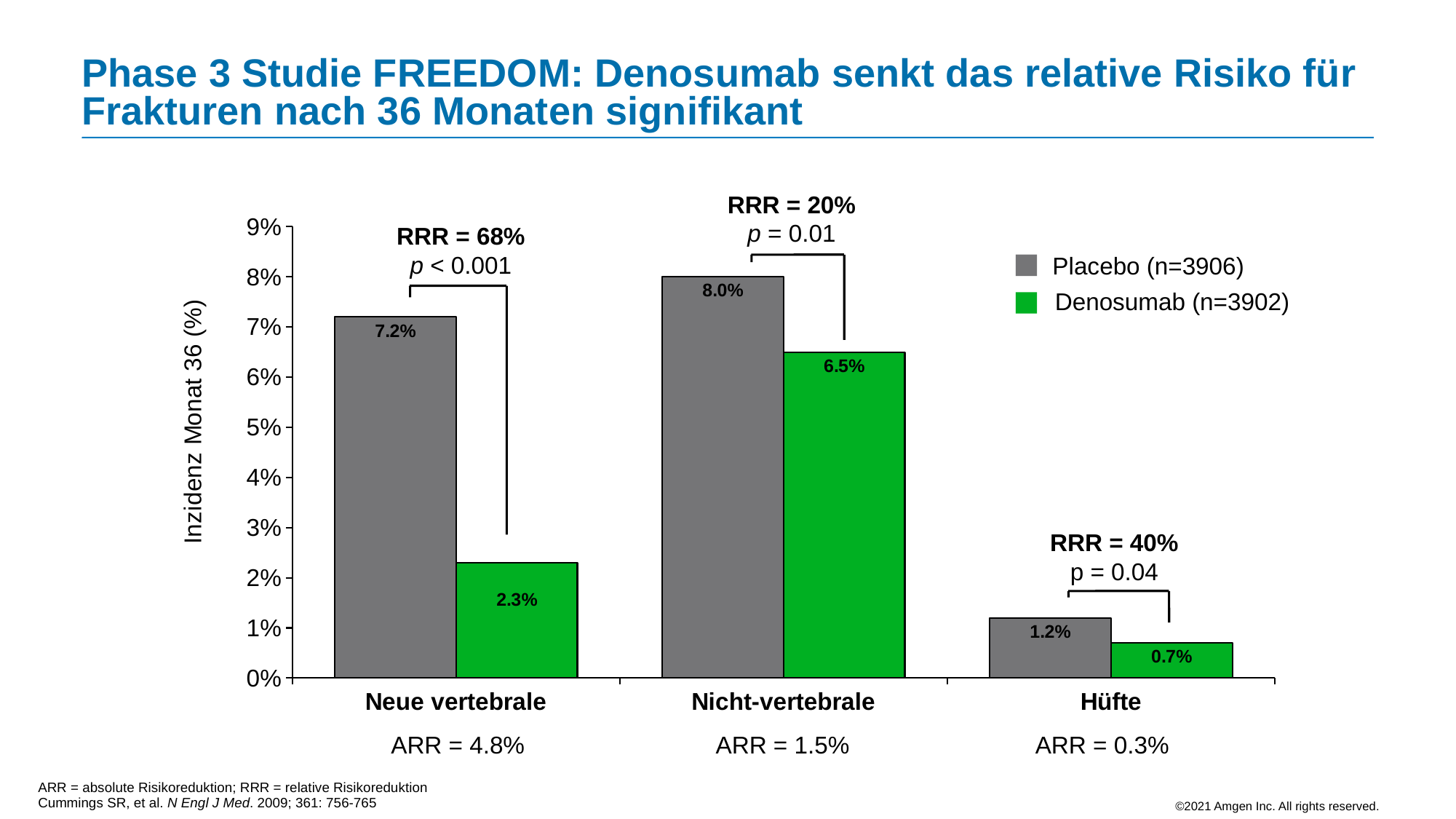
Which category has the lowest Denosumab incidence? Hüfte Which is larger in the Nicht-vertebrale category, the Placebo or the Denosumab incidence? Placebo What is the difference between the Placebo and Denosumab incidence in the Neue vertebrale category? 4.9% What kind of chart is shown on the slide? Bar chart How many fracture categories are shown on the x axis? 3 What is the incidence for Denosumab in the Hüfte category? 0.7% Which category has the highest Placebo incidence? Nicht-vertebrale What is the label of the y axis? Inzidenz Monat 36 (%) How many series does the legend list? 2 What is the incidence for Placebo in the Neue vertebrale category? 7.2% Is the Placebo value for Nicht-vertebrale greater or less than 7%? greater What is the incidence for Denosumab in the Nicht-vertebrale category? 6.5%